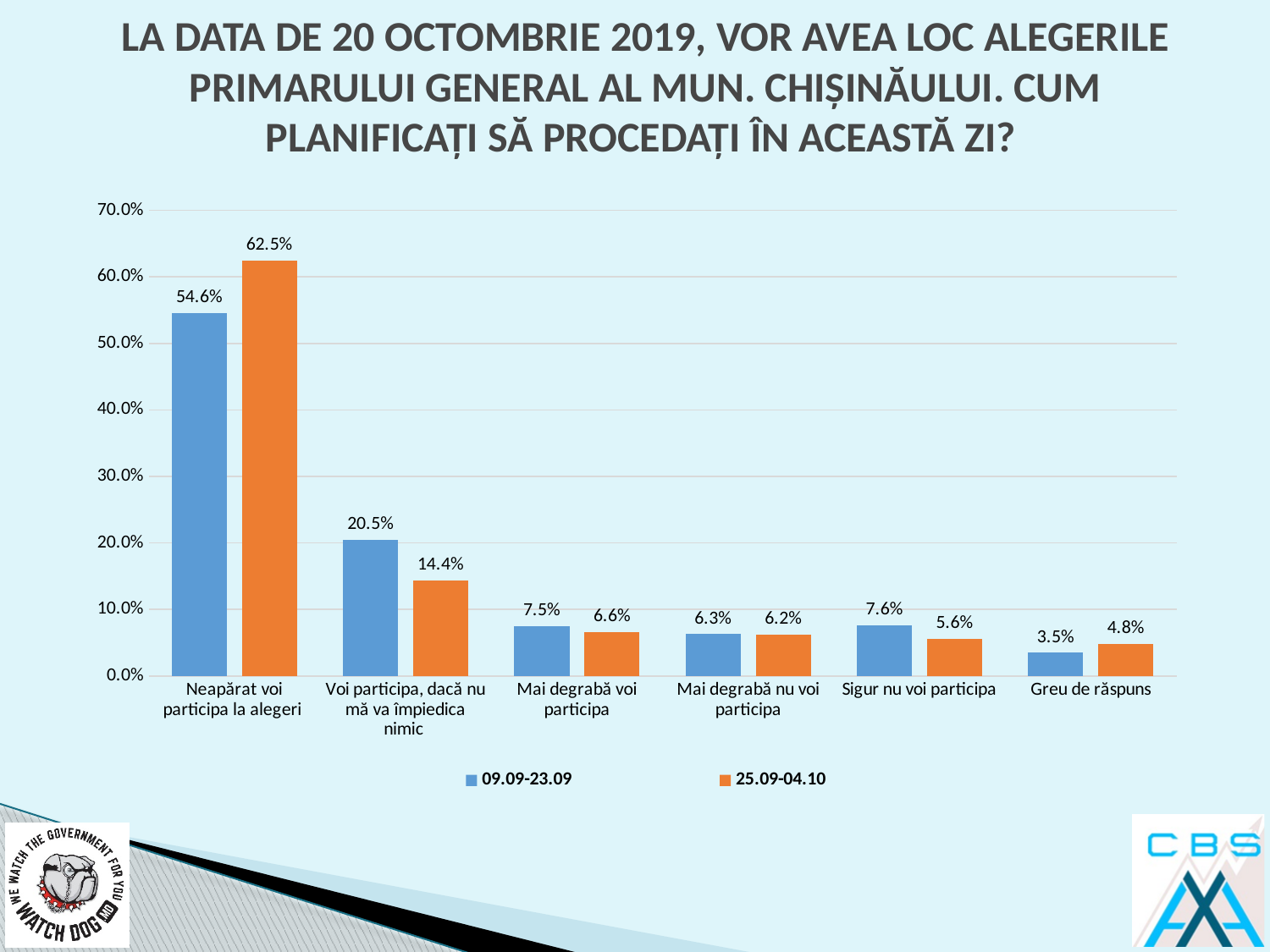
For "Sigur nu voi participa", which series has the larger value: 09.09-23.09 or 25.09-04.10? 09.09-23.09 How many series does the legend list? 2 Is the 09.09-23.09 value for "Neapărat voi participa la alegeri" greater or less than 50.0%? greater Which category has the highest value in the 09.09-23.09 series? Neapărat voi participa la alegeri What is the difference between the 09.09-23.09 and 25.09-04.10 values for "Voi participa, dacă nu mă va împiedica nimic"? 6.1% What is the value for "Neapărat voi participa la alegeri" in the 25.09-04.10 series? 62.5% What is the value for "Voi participa, dacă nu mă va împiedica nimic" in the 09.09-23.09 series? 20.5% What kind of chart is shown on the slide? Bar chart What is the difference between the 25.09-04.10 and 09.09-23.09 values for "Neapărat voi participa la alegeri"? 7.9% How many categories are shown on the x axis? 6 Which category has the lowest value in the 25.09-04.10 series? Greu de răspuns What is the value for "Greu de răspuns" in the 25.09-04.10 series? 4.8%